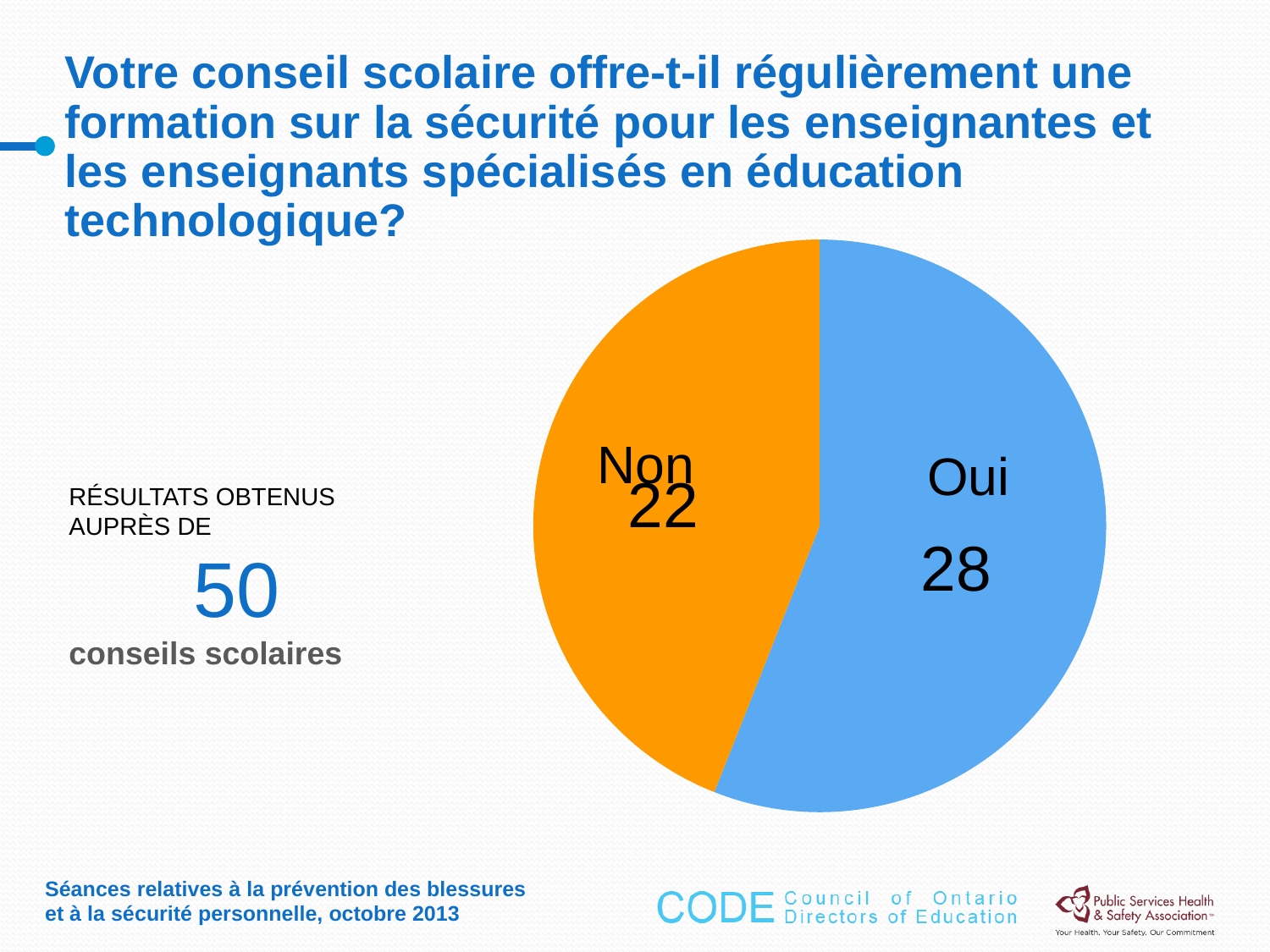
Which slice is the smallest? Non What share of the pie does the Non slice represent? 44% What colour is the Non slice? orange Which is larger, Oui or Non? Oui How many slices does the pie chart have? 2 What share of the pie does the Oui slice represent? 56% What kind of chart is shown on the slide? pie chart What is the total of the two slices? 50 Which slice is the largest? Oui What is the value for Non? 22 What is the difference between the Oui and Non values? 6 What is the value for Oui? 28